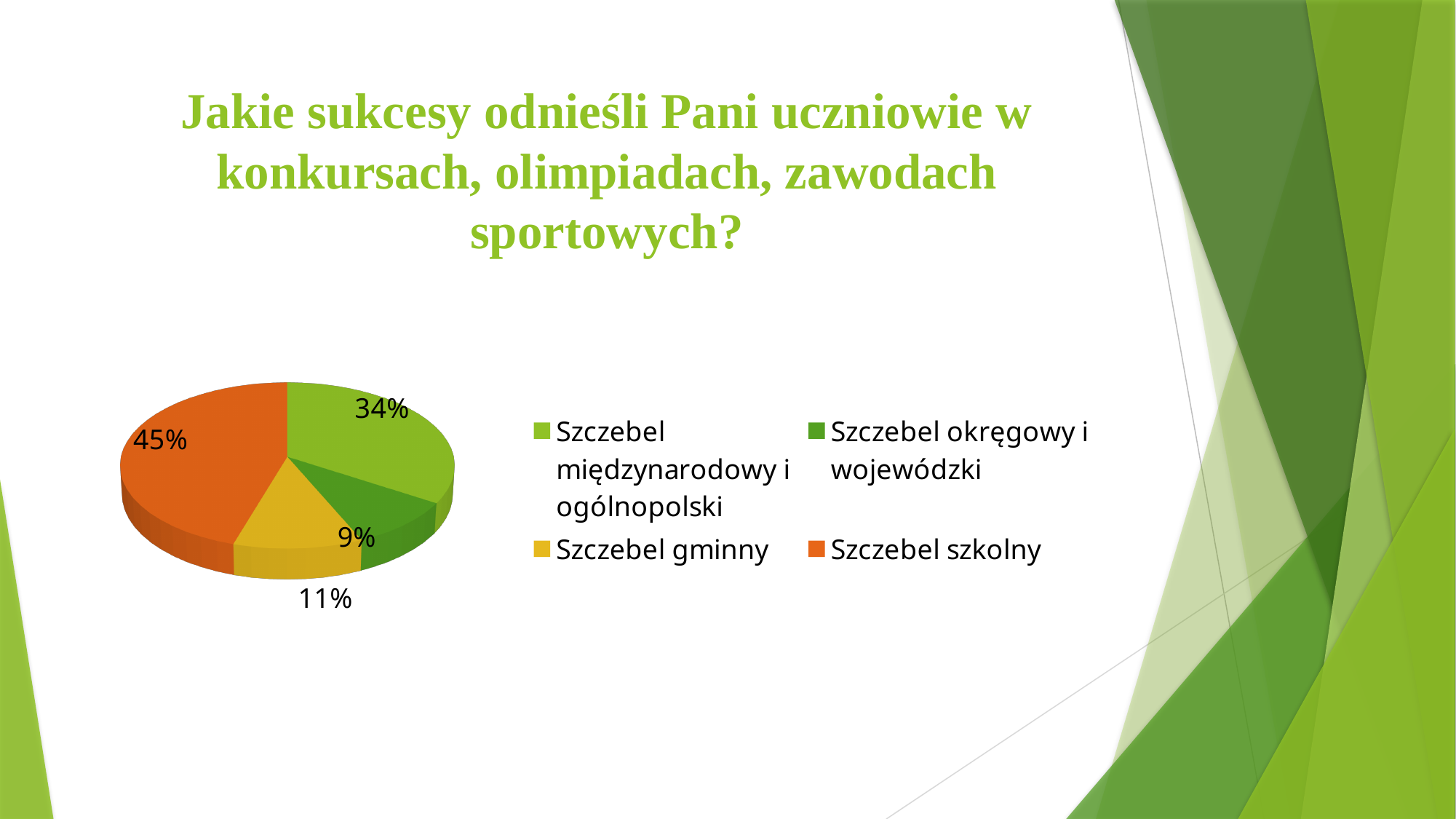
What share of the pie does "Szczebel okręgowy i wojewódzki" have? 9% Which category has the largest slice of the pie? Szczebel szkolny How many categories does the pie chart have? 4 What is the difference in percentage points between "Szczebel szkolny" and "Szczebel międzynarodowy i ogólnopolski"? 11 What share of the pie does "Szczebel gminny" have? 11% What kind of chart is shown on the slide? pie chart What share of the pie does "Szczebel międzynarodowy i ogólnopolski" have? 34% What colour is the slice for "Szczebel szkolny"? orange Which category has the smallest slice of the pie? Szczebel okręgowy i wojewódzki Which is larger: the share for "Szczebel gminny" or for "Szczebel okręgowy i wojewódzki"? Szczebel gminny What is the difference in percentage points between "Szczebel gminny" and "Szczebel okręgowy i wojewódzki"? 2